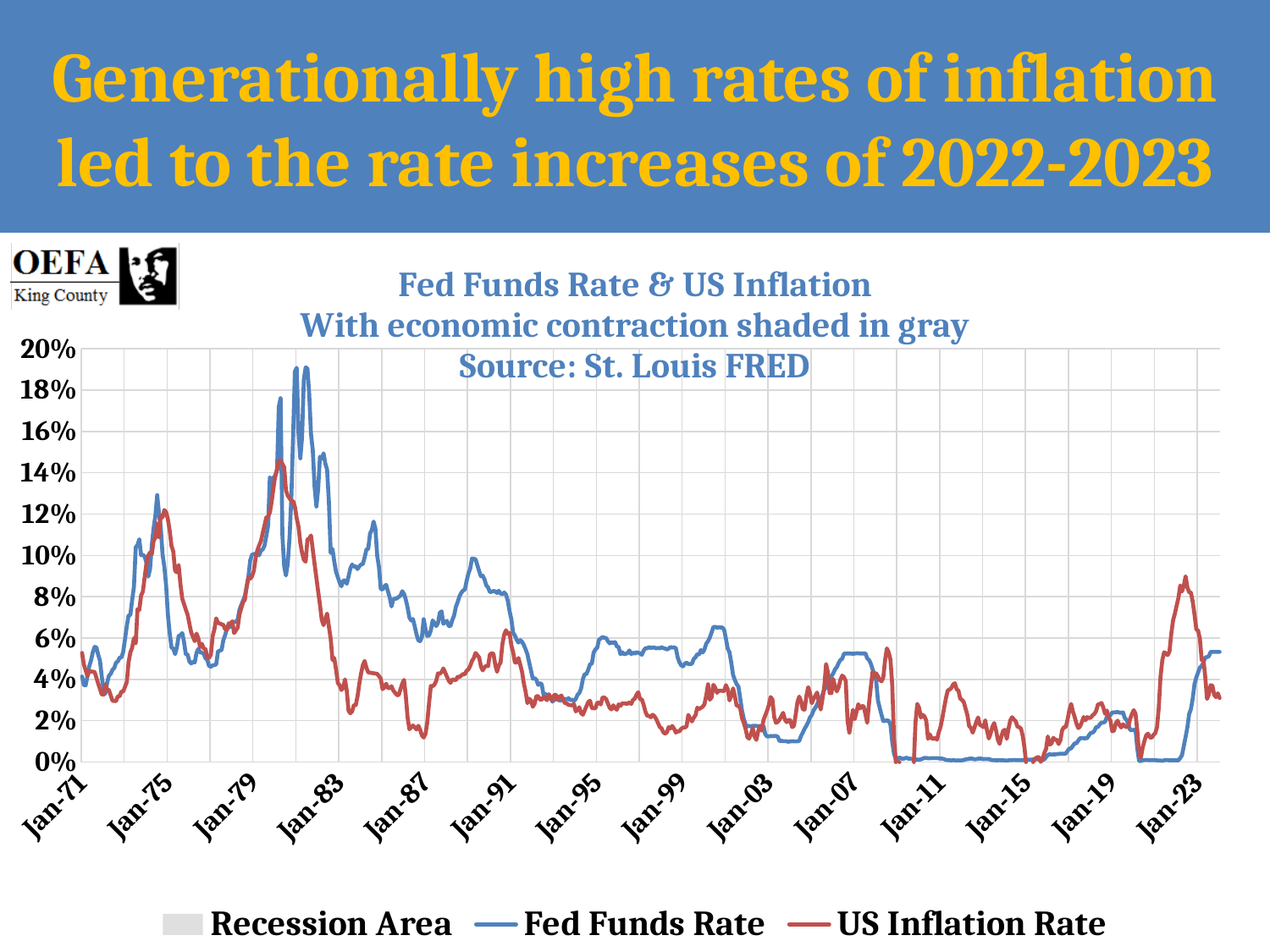
Is the US Inflation Rate at Jan-75 greater or less than 10%? greater How many date labels are shown on the x axis? 14 Which series reaches the highest value anywhere on the chart, Fed Funds Rate or US Inflation Rate? Fed Funds Rate At Jan-95, which is larger, the Fed Funds Rate or the US Inflation Rate? Fed Funds Rate Is the Fed Funds Rate around Jan-11 greater or less than 2%? less Does the Fed Funds Rate rise or fall between Jan-07 and Jan-11? Fall How many entries does the chart legend list? 3 Is the peak value of the Fed Funds Rate in the early 1980s greater or less than 18%? greater What kind of chart is shown on the slide? Line chart What is the source cited in the chart title? St. Louis FRED What colour is the US Inflation Rate line? Red